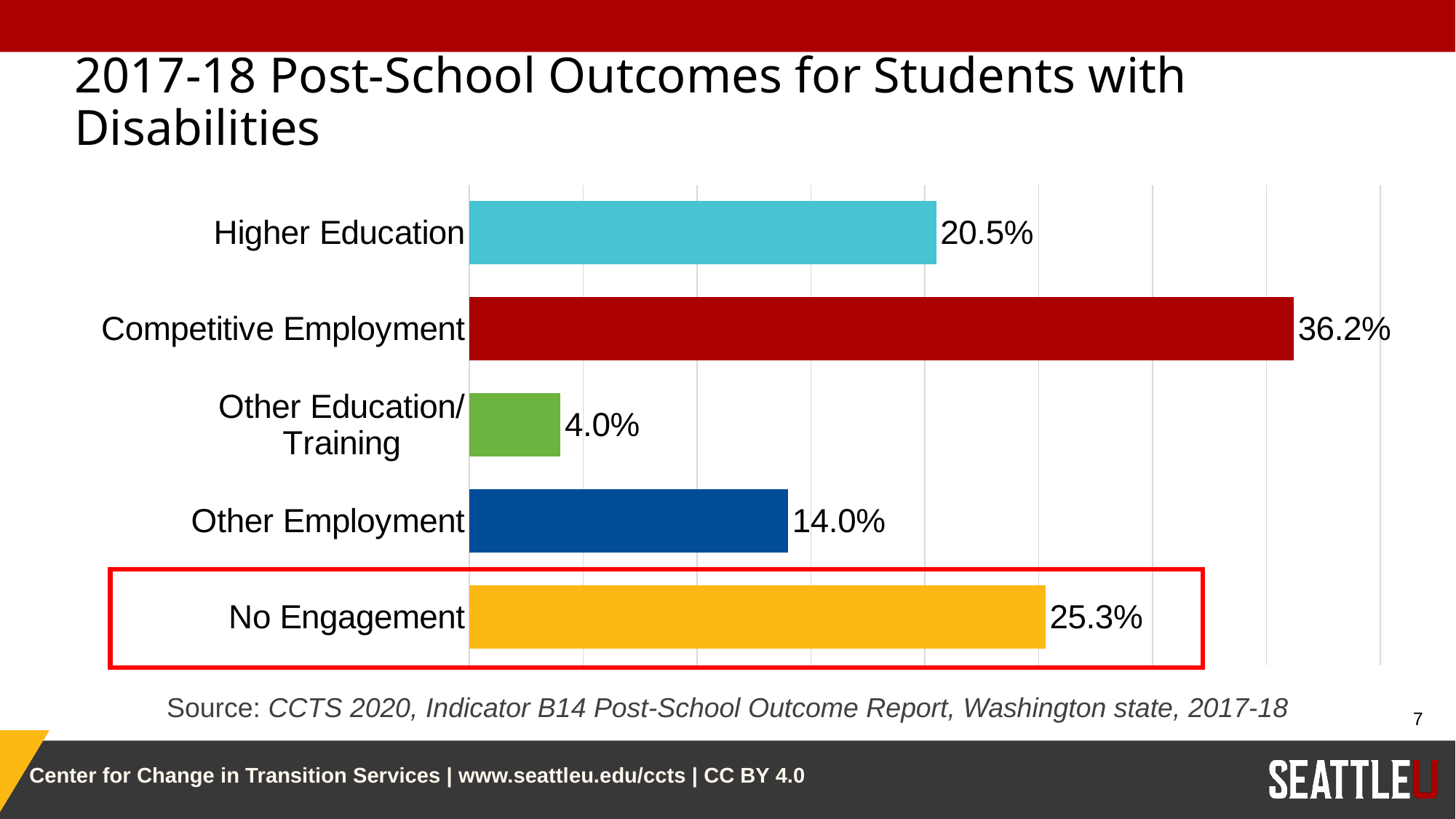
Which is larger, the value for Higher Education or the value for No Engagement? No Engagement What is the value for No Engagement? 25.3% What kind of chart is shown on the slide? Bar chart Which category is highlighted with a red box? No Engagement What is the difference between the values for Competitive Employment and No Engagement? 10.9% What is the difference between the values for Higher Education and Other Employment? 6.5% What is the value for Competitive Employment? 36.2% Which category has the highest value? Competitive Employment What is the value for Other Education/Training? 4.0% Which category has the lowest value? Other Education/Training What is the value for Higher Education? 20.5% How many categories are shown in the chart? 5